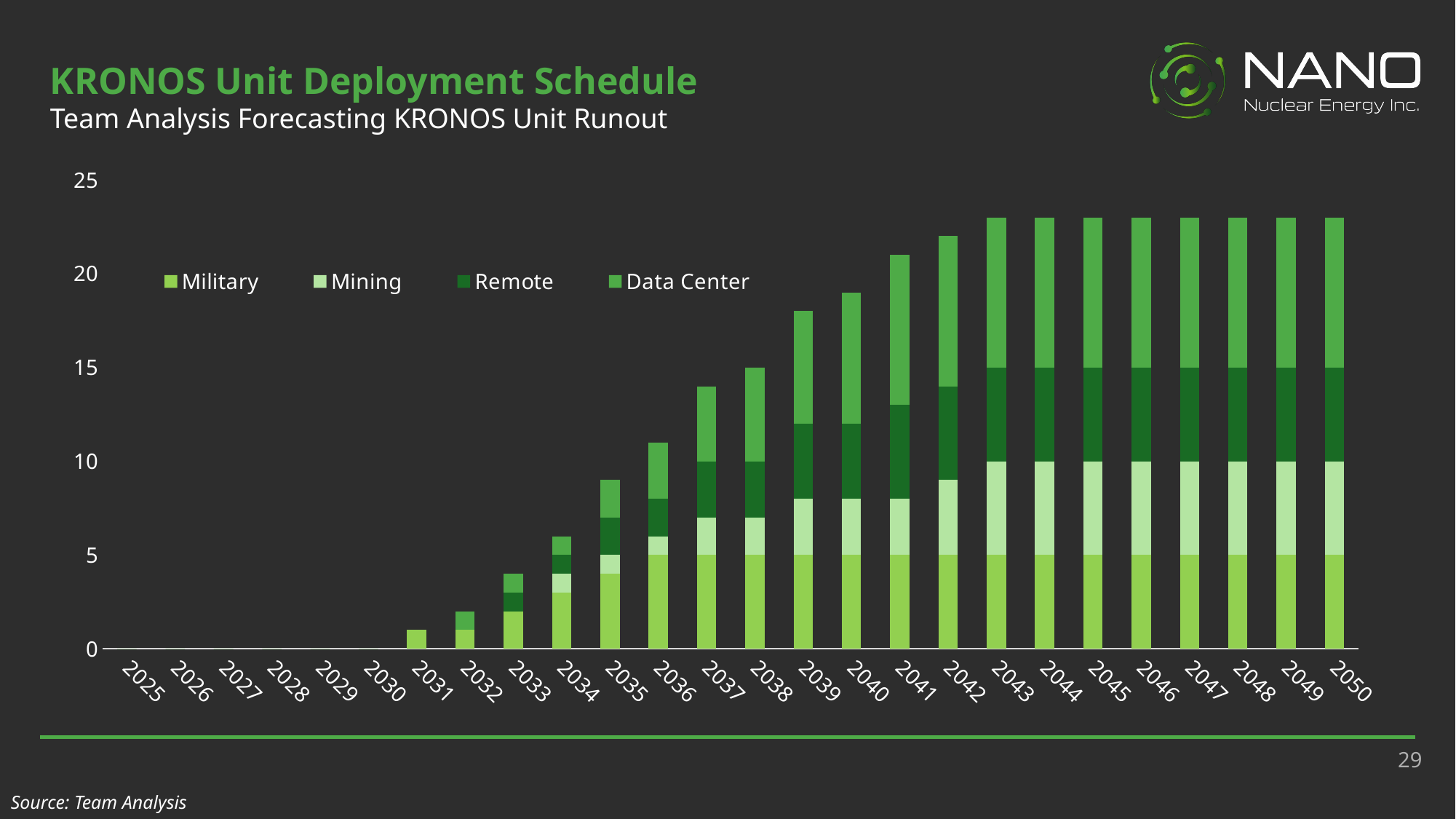
What is the first year on the x axis with a visible bar? 2031 Which year has the larger total stacked value, 2036 or 2042? 2042 Is the total stacked value for 2033 greater or less than 5? less What is the total stacked value for 2038? 15 Is the total stacked value for 2035 greater or less than 10? less Is the total stacked value for 2050 greater or less than 20? greater What are the four series named in the legend? Military, Mining, Remote, Data Center Do the total stacked values generally rise or fall from 2031 to 2043? rise How many years are shown on the x axis? 26 How many series does the legend list? 4 What kind of chart is shown on the slide? bar chart